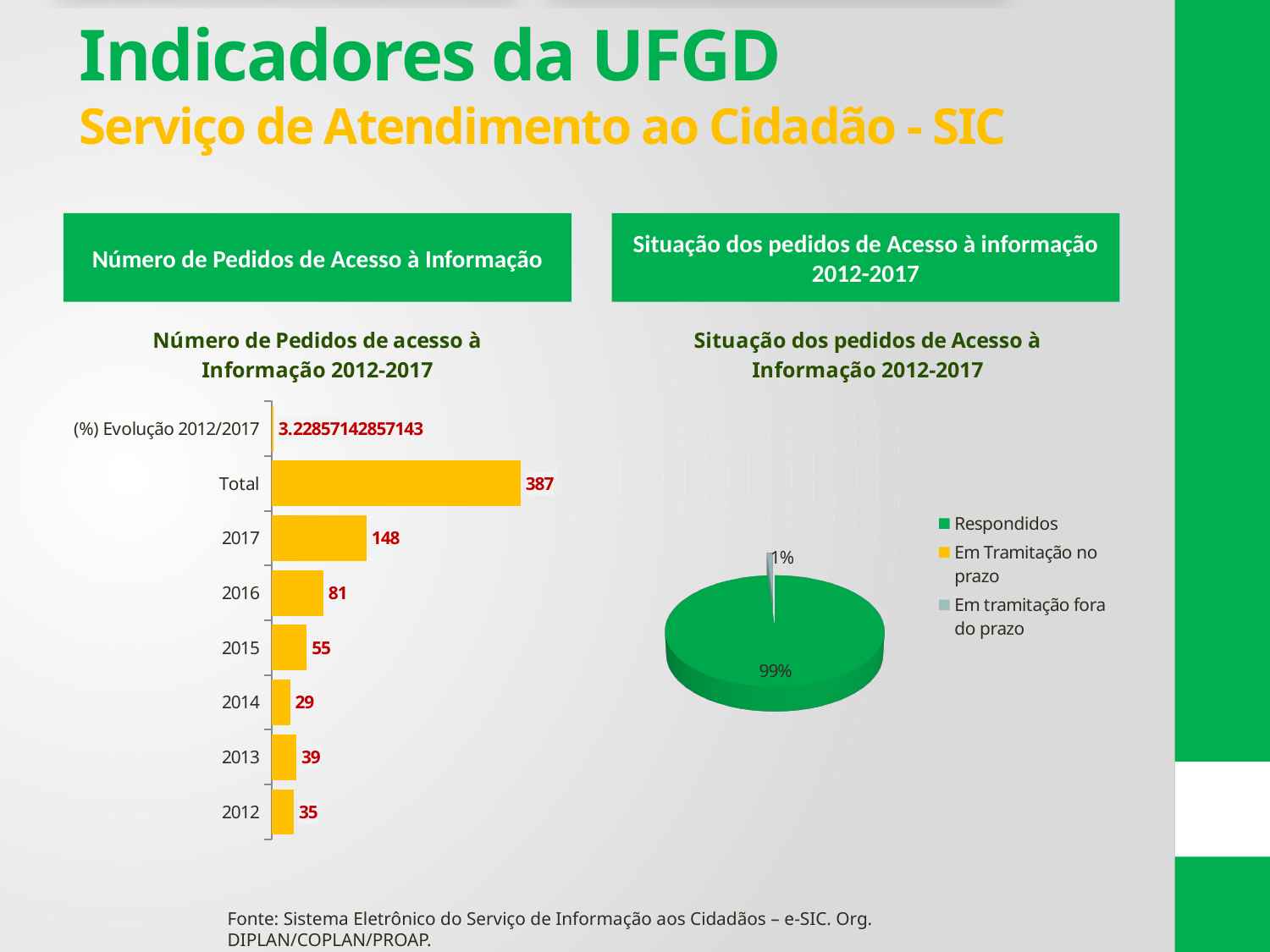
In the bar chart 'Número de Pedidos de acesso à Informação 2012-2017', what is the value labelled Total? 387 In the bar chart 'Número de Pedidos de acesso à Informação 2012-2017', what is the value for '(%) Evolução 2012/2017'? 3.22857142857143 In the bar chart 'Número de Pedidos de acesso à Informação 2012-2017', what is the value for 2014? 29 In the bar chart 'Número de Pedidos de acesso à Informação 2012-2017', which year from 2012 to 2017 has the highest value? 2017 In the pie chart 'Situação dos pedidos de Acesso à Informação 2012-2017', what share is shown for Respondidos? 99% How many entries does the legend of the pie chart 'Situação dos pedidos de Acesso à Informação 2012-2017' list? 3 In the bar chart 'Número de Pedidos de acesso à Informação 2012-2017', what is the value for 2017? 148 In the bar chart 'Número de Pedidos de acesso à Informação 2012-2017', what is the difference between the values for 2017 and 2016? 67 In the bar chart 'Número de Pedidos de acesso à Informação 2012-2017', which is larger, the value for 2013 or the value for 2012? 2013 In the bar chart 'Número de Pedidos de acesso à Informação 2012-2017', which year from 2012 to 2017 has the lowest value? 2014 What kind of chart is 'Número de Pedidos de acesso à Informação 2012-2017'? bar chart In the bar chart 'Número de Pedidos de acesso à Informação 2012-2017', do the values rise or fall from 2014 to 2017? rise